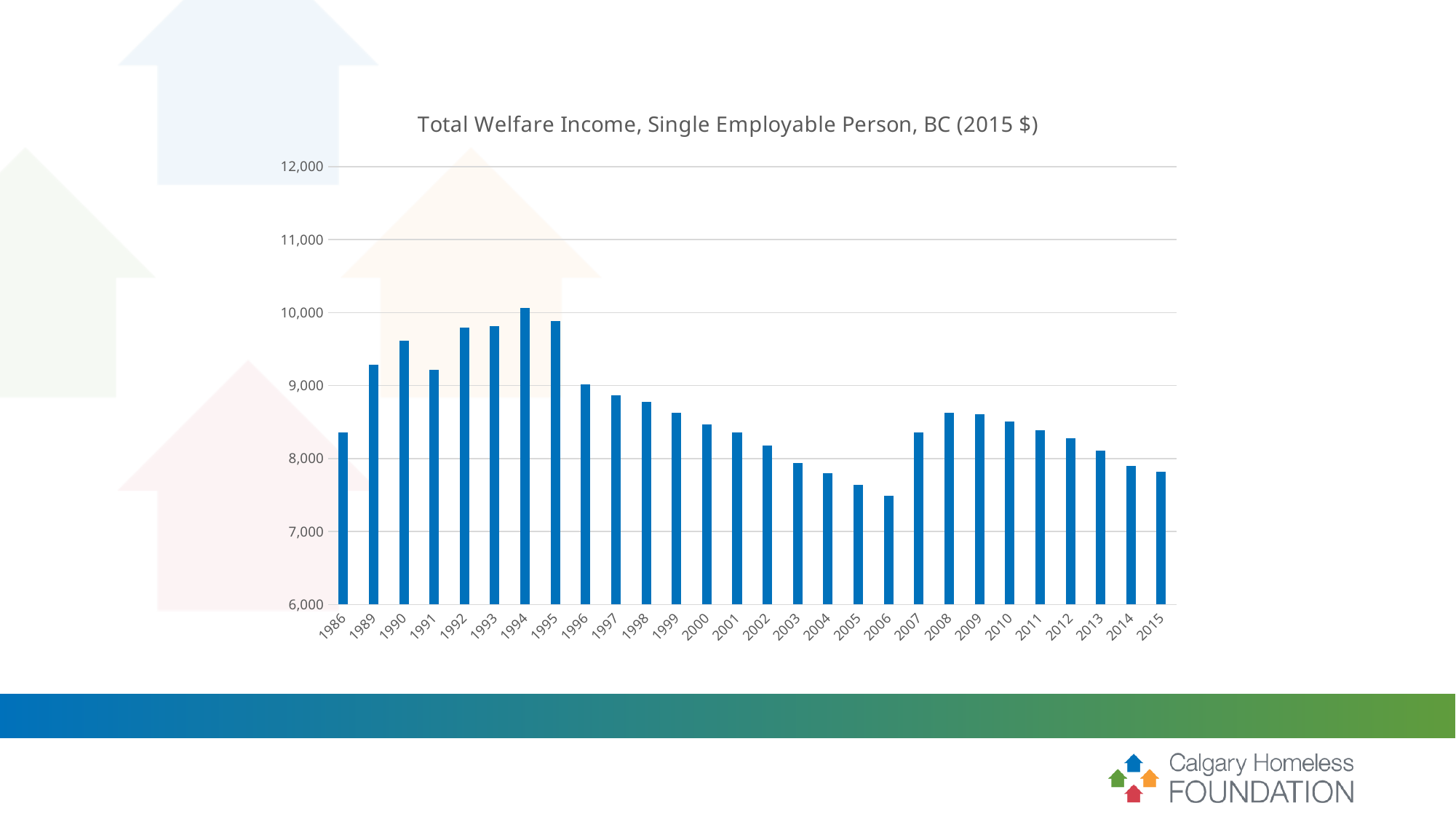
What is the title of the chart? Total Welfare Income, Single Employable Person, BC (2015 $) Is the value for 1990 greater or less than 9,000? greater Which year has the highest total welfare income? 1994 Which year has the larger value, 1990 or 2000? 1990 Is the value for 1994 greater or less than 10,000? greater Is the value for 2015 greater or less than 8,000? less Which year has the larger value, 2008 or 2015? 2008 How many years (bars) are plotted on the chart? 28 Which year has the lowest total welfare income? 2006 Do the values rise or fall from 1995 to 2006? Fall What kind of chart is shown on the slide? Bar chart